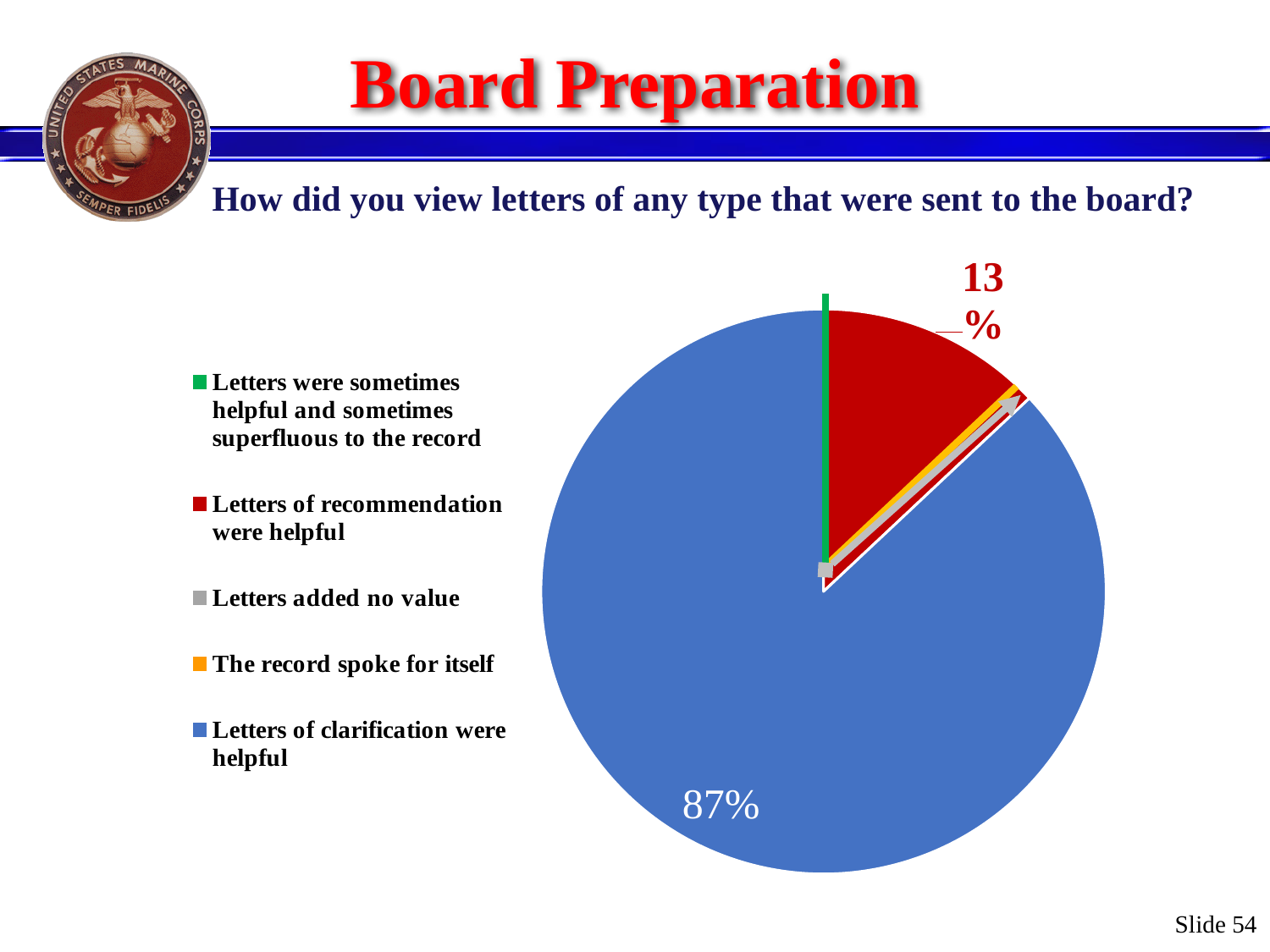
What kind of chart is shown on the slide? pie chart Which is larger: the share for 'Letters of clarification were helpful' or the share for 'Letters of recommendation were helpful'? Letters of clarification were helpful What percentage of respondents said letters of clarification were helpful? 87% Which response category has the largest share of the pie? Letters of clarification were helpful Which colour represents 'The record spoke for itself' in the legend? orange How many response categories does the legend list? 5 What share of the pie does the blue slice represent? 87% What question does the chart present responses to? How did you view letters of any type that were sent to the board? By how many percentage points does the 'Letters of clarification were helpful' share exceed the 'Letters of recommendation were helpful' share? 74 percentage points What percentage of respondents said letters of recommendation were helpful? 13%